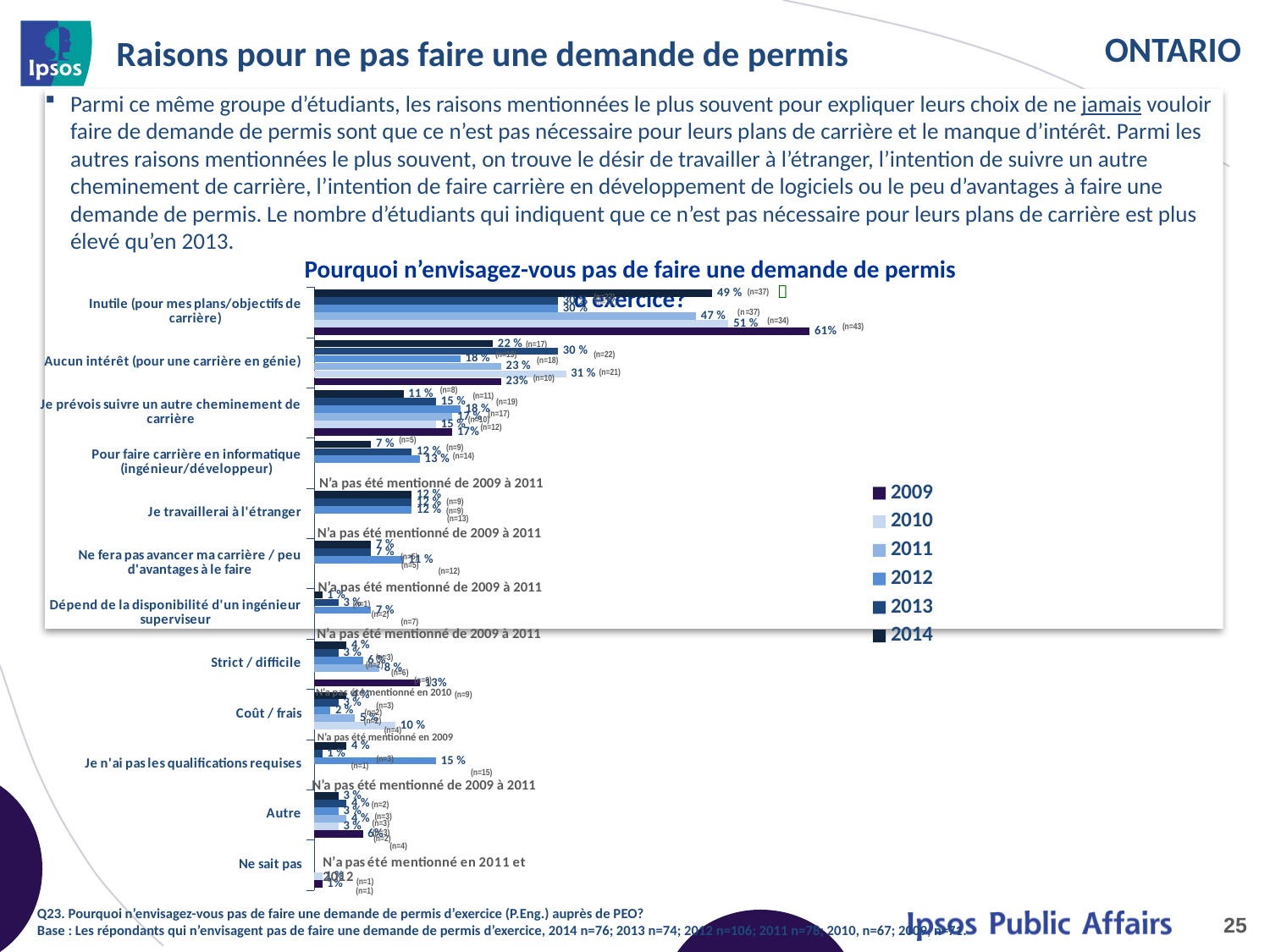
What is the title of the chart? Pourquoi n'envisagez-vous pas de faire une demande de permis d'exercice? What is the difference between the two largest values shown for 'Inutile (pour mes plans/objectifs de carrière)' (61% and 51%)? 10 percentage points How many reason categories are listed on the chart's vertical axis? 12 What is the largest percentage shown for 'Inutile (pour mes plans/objectifs de carrière)'? 61% What kind of chart is used to show the reasons for not applying for a licence? Bar chart What is the largest percentage shown for 'Aucun intérêt (pour une carrière en génie)'? 31 % How many years (series) does the chart legend list? 6 Which category carries the note 'N'a pas été mentionné en 2011 et 2012'? Ne sait pas What percentage is labelled with (n=15) for 'Je n'ai pas les qualifications requises'? 15 % Which reason category has the highest value shown anywhere on the chart? Inutile (pour mes plans/objectifs de carrière) What is the smallest percentage shown for 'Pour faire carrière en informatique (ingénieur/développeur)'? 7 % Which years are listed in the chart legend? 2009, 2010, 2011, 2012, 2013, 2014